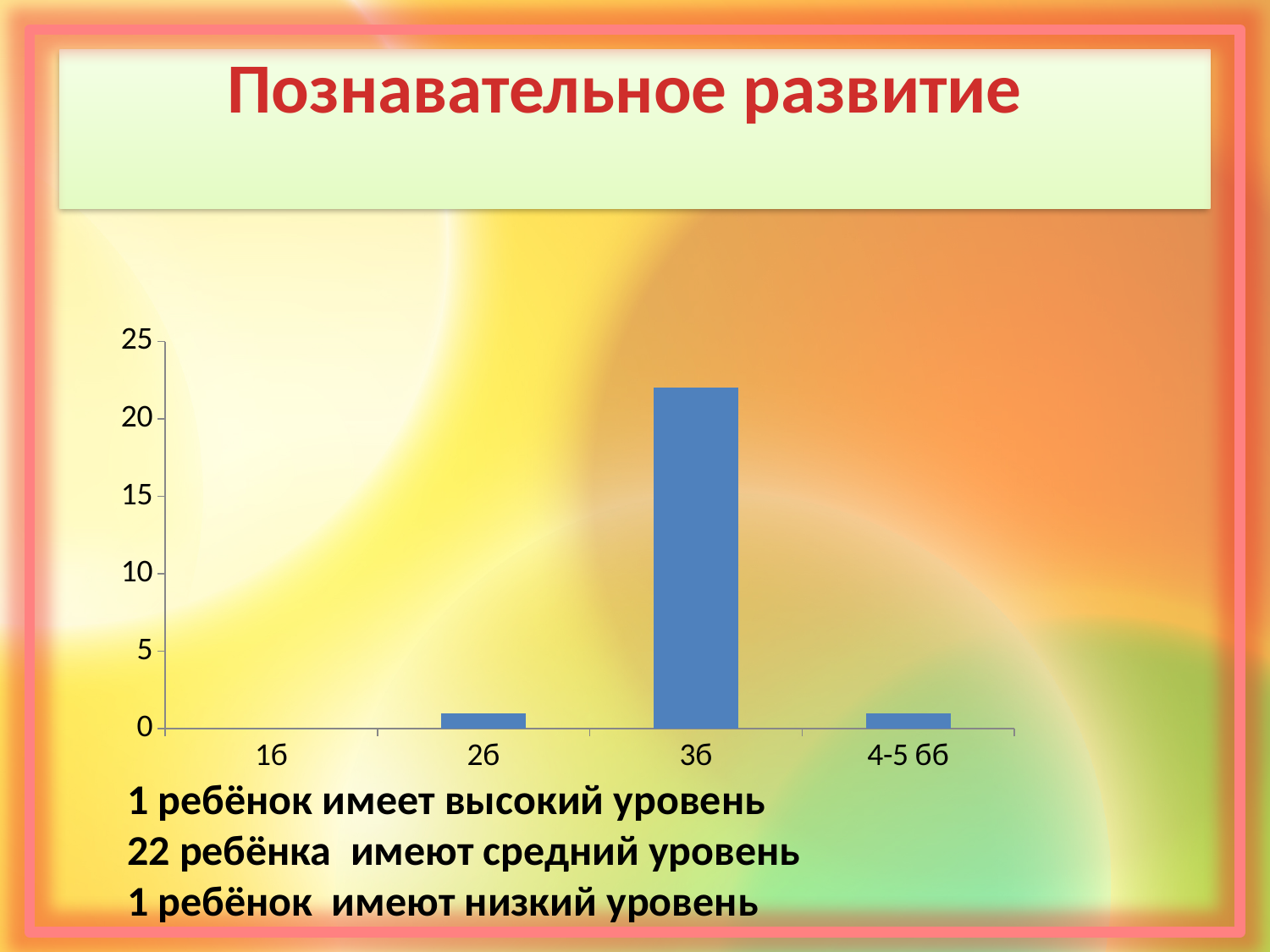
Which category has the highest bar in the chart? 3б What colour are the bars in the chart? blue Which category has the lowest value in the chart? 1б How many categories are shown on the x axis of the chart? 4 Is the value for 4-5 бб greater or less than 5? less Is the value for 3б greater or less than 25? less What kind of chart is shown on the slide? bar chart Which is larger, the value for 3б or the value for 2б? 3б Is the value for 2б greater or less than 5? less Which is larger, the value for 4-5 бб or the value for 1б? 4-5 бб What is the title shown at the top of the slide above the chart? Познавательное развитие